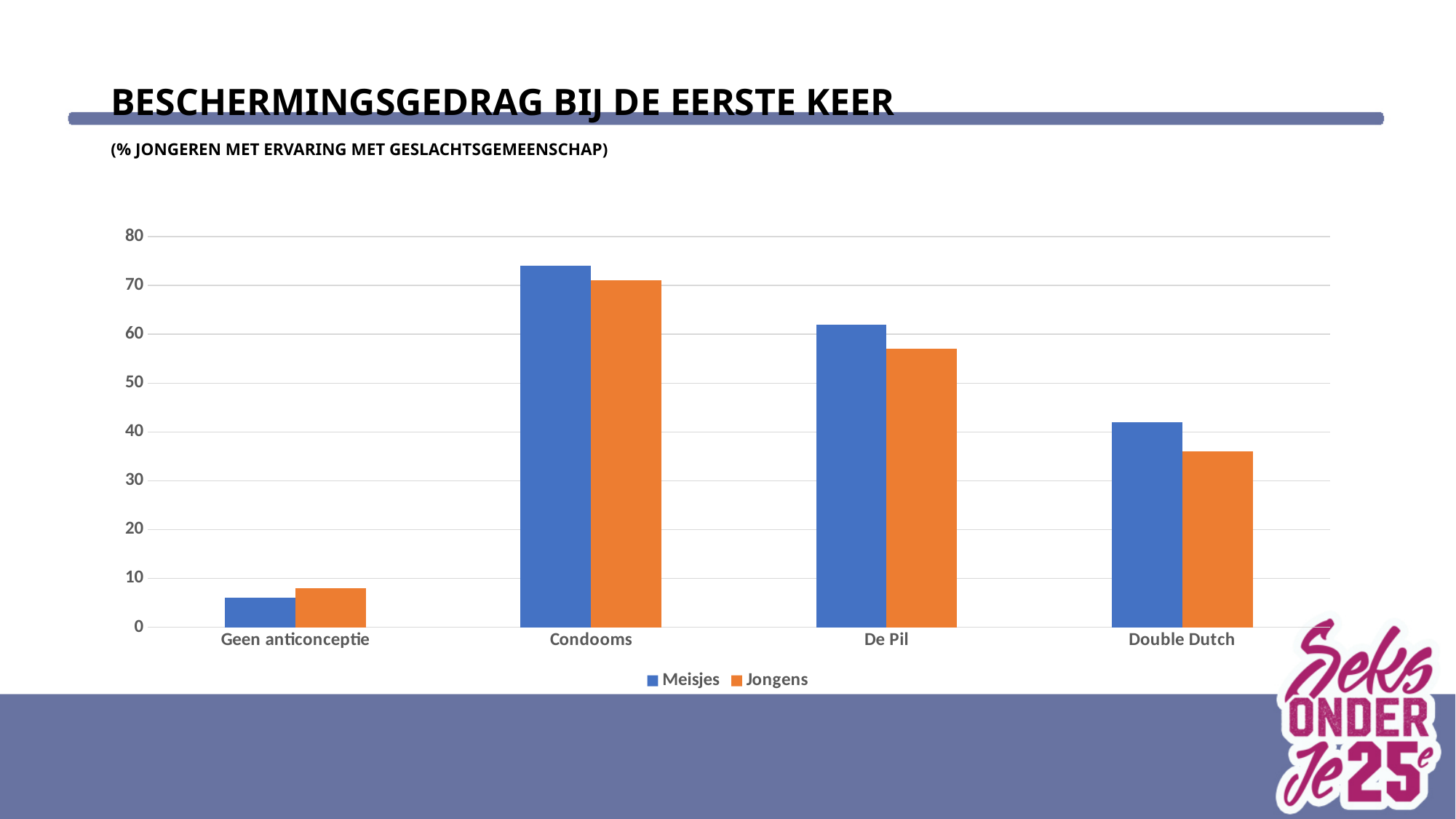
How many series does the legend list? 2 How many categories are shown on the x axis? 4 Which category has the lowest value for Jongens? Geen anticonceptie Is the Jongens value for De Pil greater or less than 60? less What kind of chart is shown on the slide? bar chart For Geen anticonceptie, which is larger: the value for Meisjes or for Jongens? Jongens Is the Meisjes value for Geen anticonceptie greater or less than 10? less Is the Meisjes value for Condooms greater or less than 70? greater For De Pil, which is larger: the value for Meisjes or for Jongens? Meisjes Which colour represents the Jongens series in the chart? orange Which category has the highest value for Meisjes? Condooms